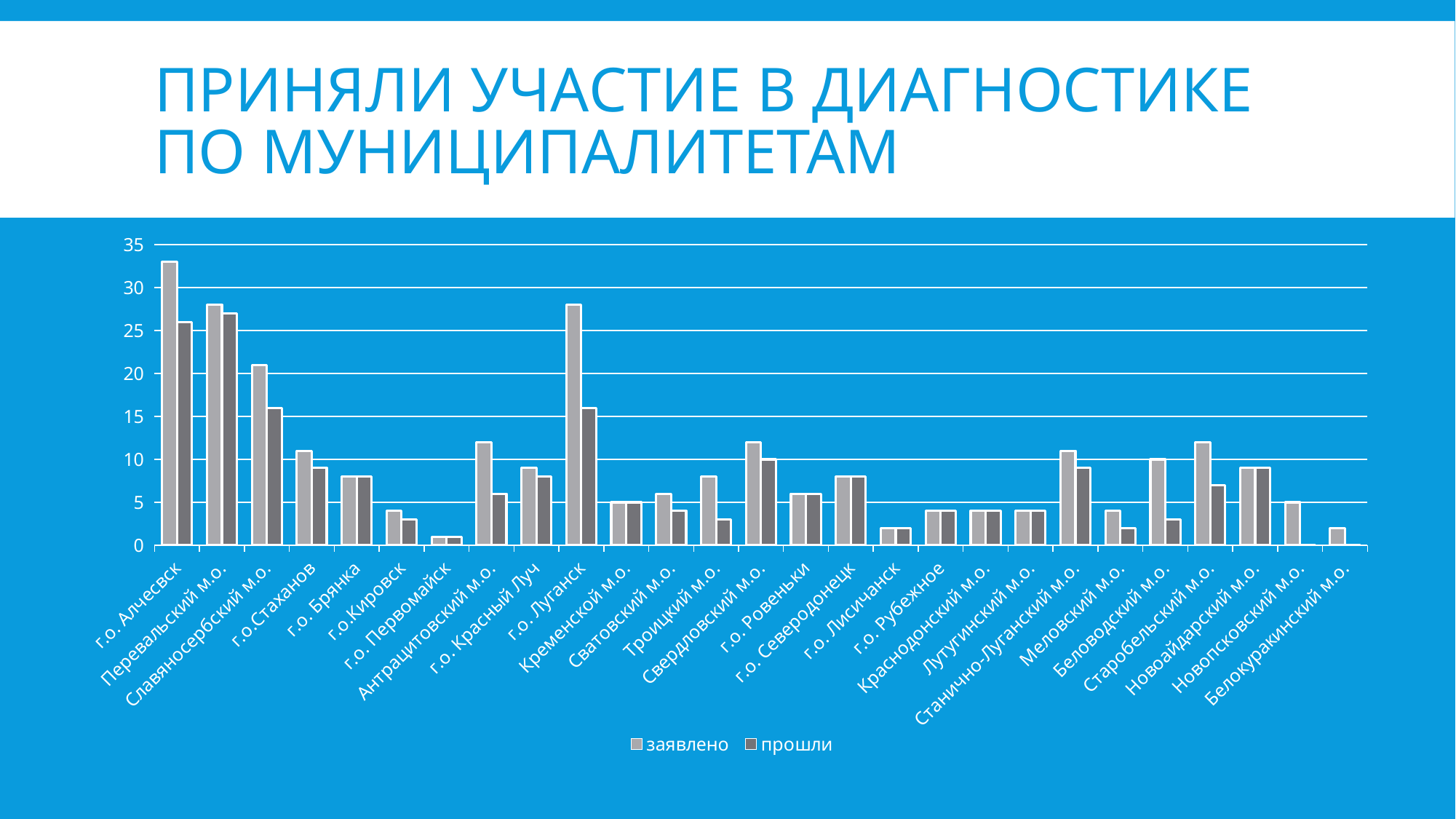
Which is larger: заявлено for г.о. Алчевск or заявлено for г.о. Луганск? г.о. Алчевск Is the value for заявлено in г.о. Луганск greater or less than 30? less Is the value for прошли in г.о. Луганск greater or less than 10? greater What are the two series named in the legend? заявлено, прошли What kind of chart is shown on the slide? bar chart Which municipality has the highest value for заявлено? г.о. Алчесвск Is the value for прошли in Перевальский м.о. greater or less than 25? greater Which is larger: прошли for Перевальский м.о. or прошли for Славяносербский м.о.? Перевальский м.о. Which municipality has the lowest value for заявлено? г.о. Первомайск How many series does the legend list? 2 How many municipalities (categories) are shown on the x axis? 27